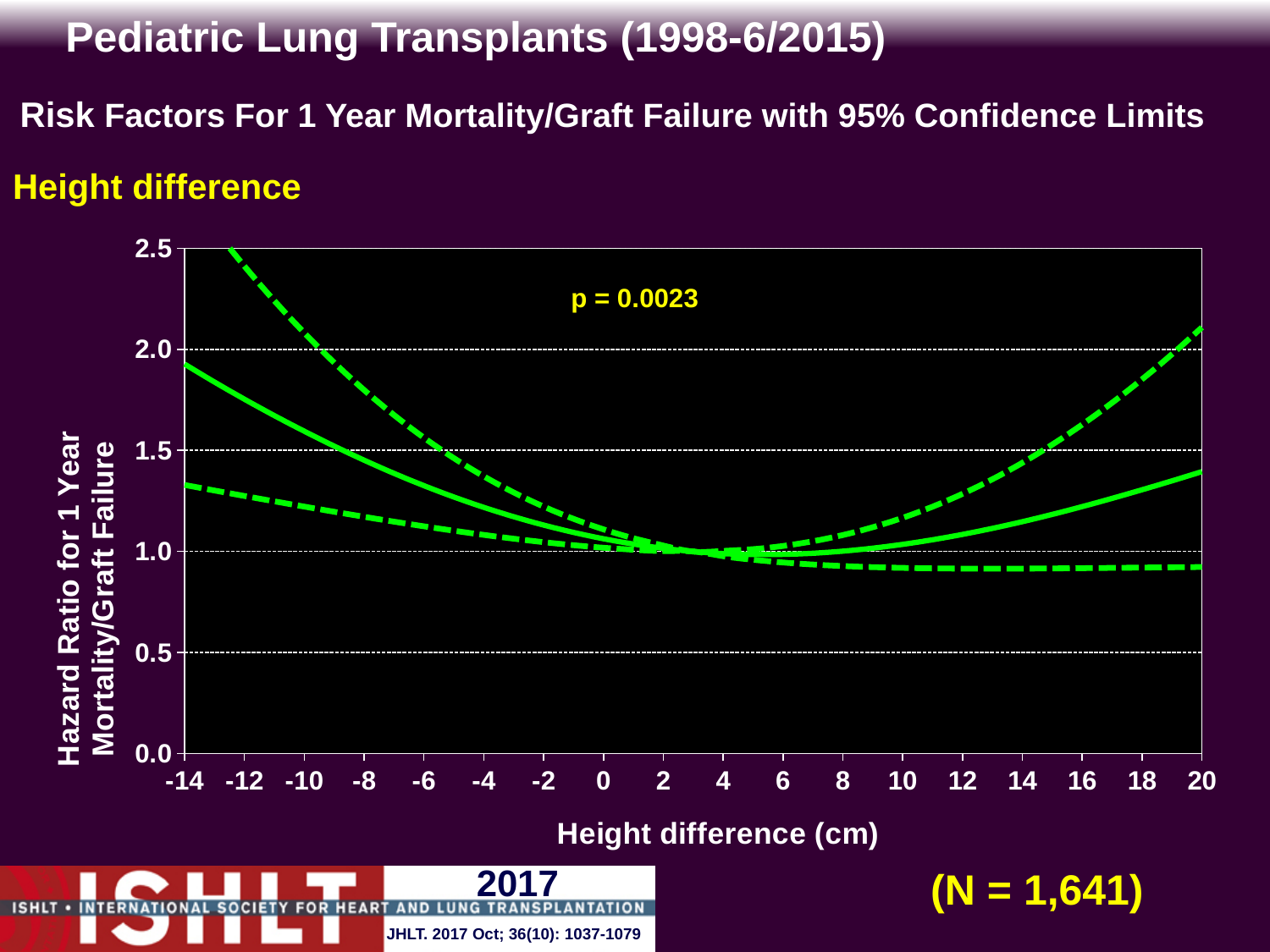
Is the value of the upper dashed line at a height difference of -12 cm greater or less than 2.0? greater Is the value of the lower dashed line at a height difference of -14 cm greater or less than 1.5? less Is the value of the solid line at a height difference of -14 cm greater or less than 1.5? greater Is the solid line higher at a height difference of -14 cm or at 20 cm? -14 cm What p-value is printed on the chart? p = 0.0023 Does the solid line rise or fall as the height difference goes from 6 cm to 20 cm? rise How many lines are plotted on the chart? 3 Does the solid line rise or fall as the height difference goes from -14 cm to 0 cm? fall What kind of chart is shown on the slide? line chart What sample size (N) is shown on the slide? N = 1,641